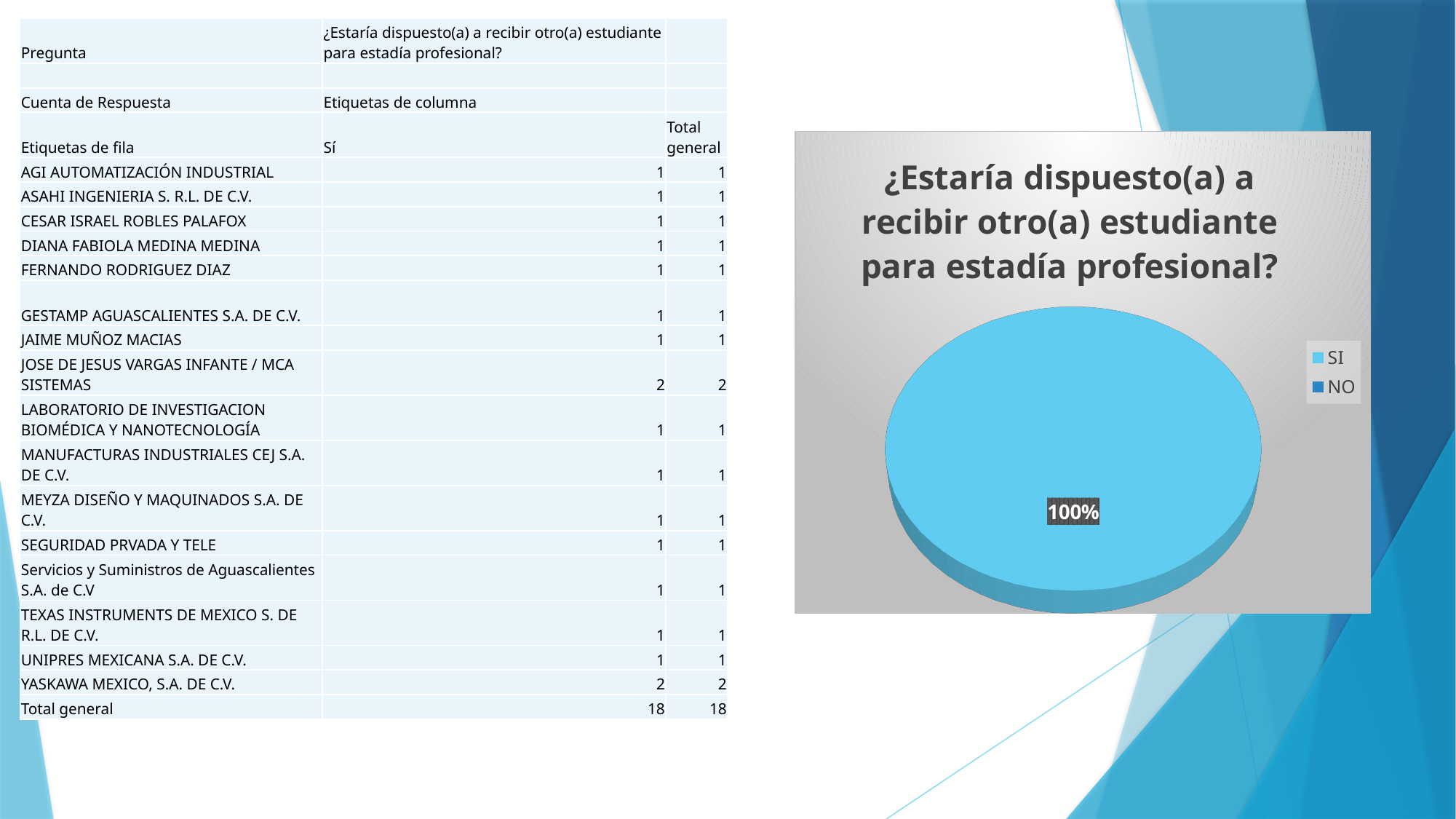
How many entries does the legend of the pie chart list? 2 What is the data label shown on the pie chart? 100% What kind of chart is shown on the slide? pie chart Which is larger in the pie chart, SI or NO? SI Which category has the smallest share of the pie chart? NO What share of the pie does the SI slice represent? 100% How many visible slices does the pie chart have? 1 Which category has the largest share of the pie chart? SI What is the title of the pie chart? ¿Estaría dispuesto(a) a recibir otro(a) estudiante para estadía profesional? What are the two legend entries of the pie chart? SI and NO